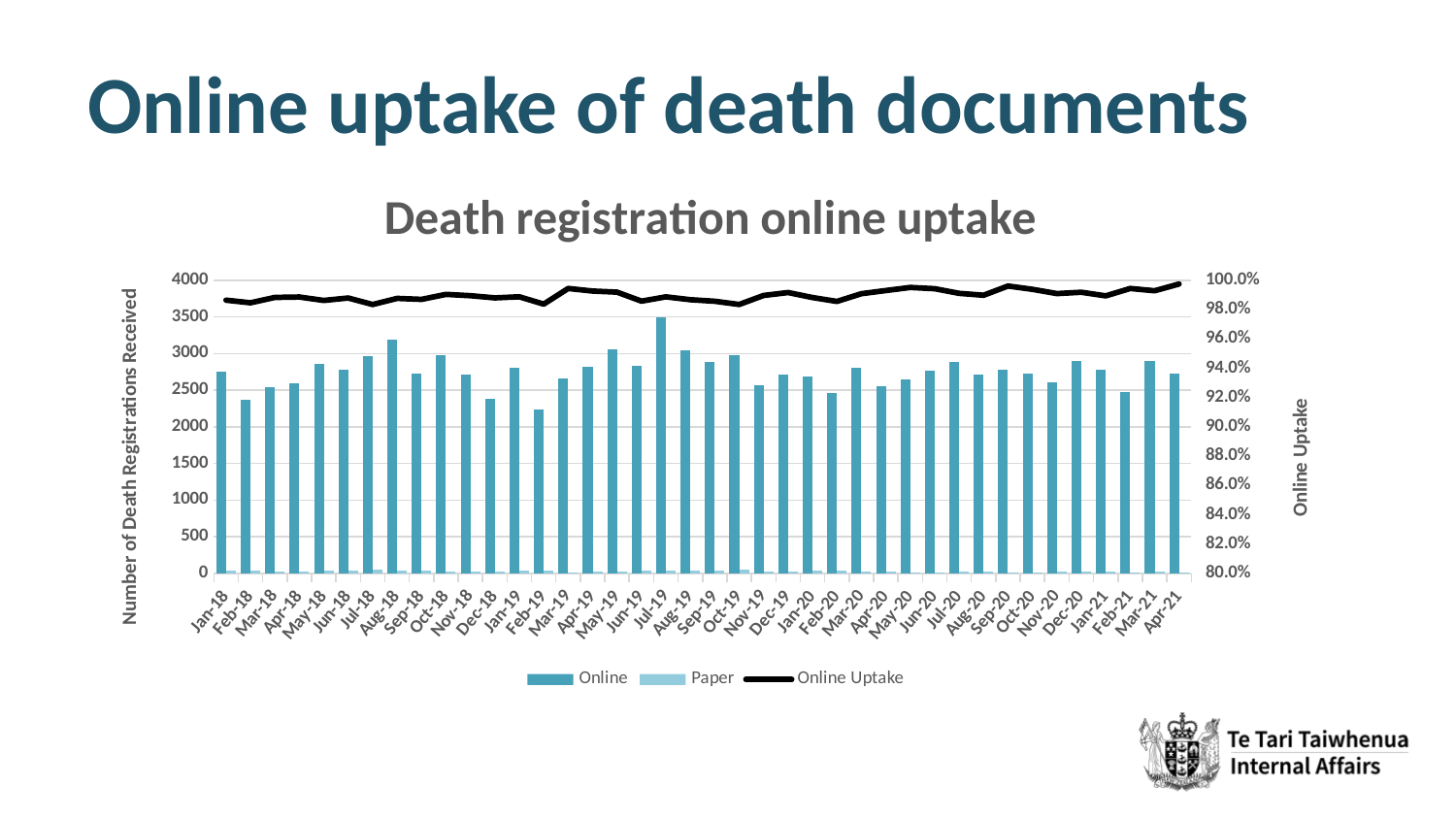
Is the Online value for Jul-19 greater or less than 3000? greater Which month has the highest Online bar? Jul-19 Is the Online value for Aug-18 greater or less than 3000? greater Which month has the lowest Online bar? Feb-19 How many series does the chart legend list? 3 What is the label on the left vertical axis of the chart? Number of Death Registrations Received What is the title of the chart? Death registration online uptake How many months are shown along the x axis of the chart? 40 Is the Online Uptake line for every month greater or less than 96.0%? greater What kind of chart is shown on the slide? Bar chart with a line Which is larger, the Online value for Jan-18 or for Feb-18? Jan-18